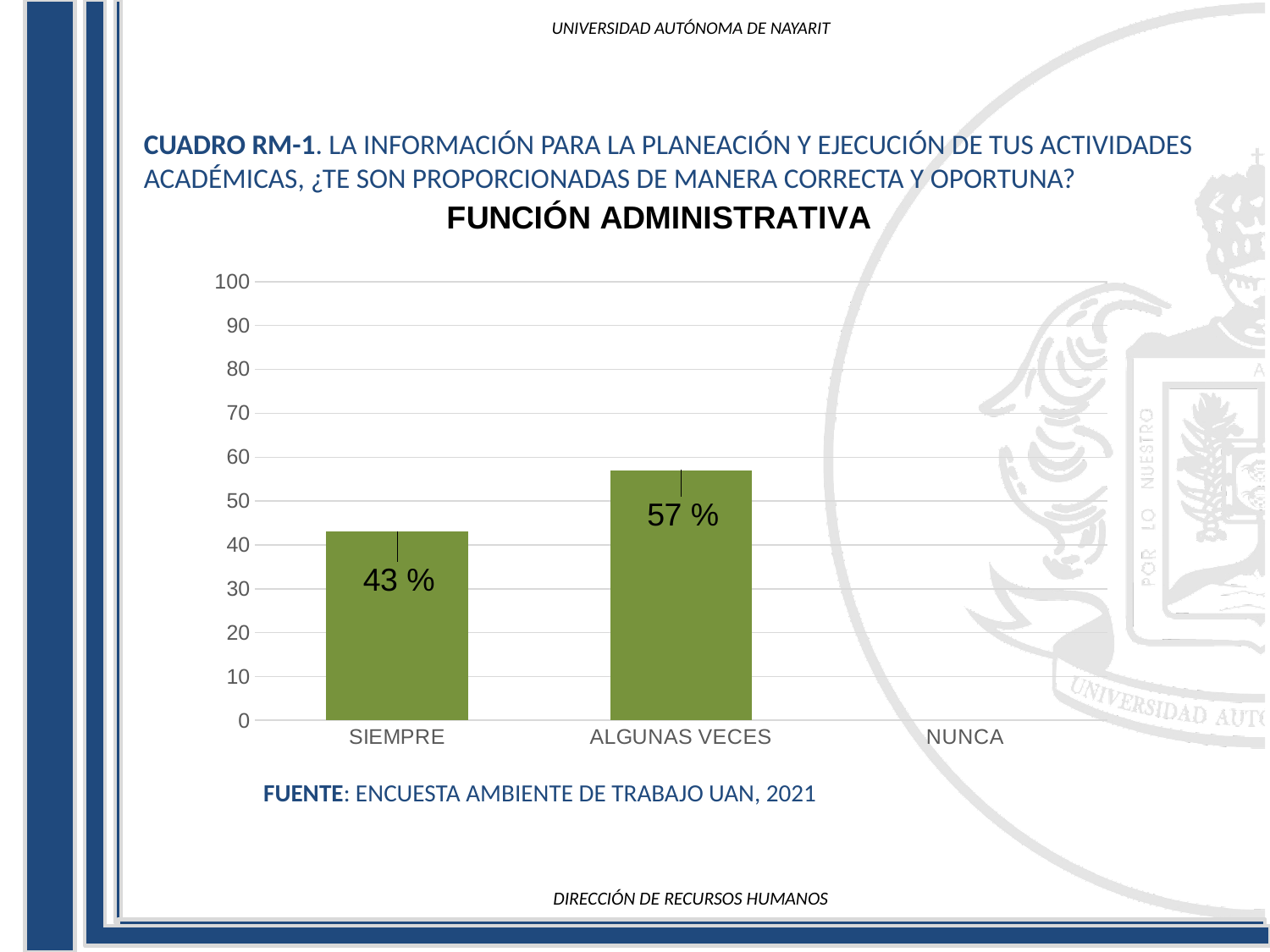
What is the value for SIEMPRE? 43 % What is the title of the chart? FUNCIÓN ADMINISTRATIVA What is the maximum value shown on the y axis? 100 Is the value for SIEMPRE greater or less than 50? less Which category has the highest value? ALGUNAS VECES Which is larger, the value for SIEMPRE or the value for ALGUNAS VECES? ALGUNAS VECES What is the value for ALGUNAS VECES? 57 % What kind of chart is shown on the slide? bar chart What is the difference between the values for ALGUNAS VECES and SIEMPRE? 14 % Is the value for ALGUNAS VECES greater or less than 50? greater How many categories are shown on the x axis? 3